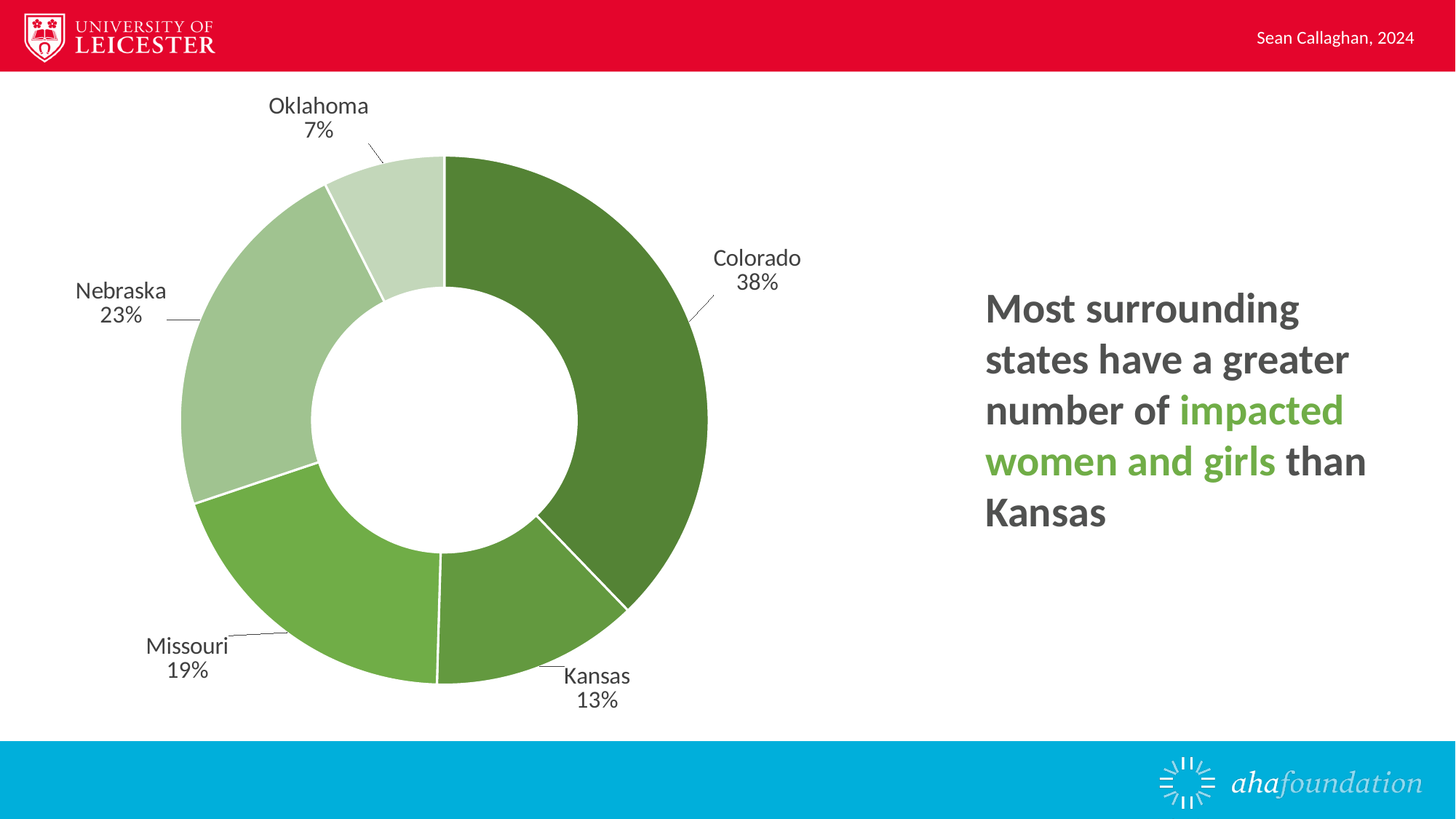
What share of the pie does Oklahoma have? 7% How many states are shown in the chart? 5 What share of the pie does Missouri have? 19% What share of the pie does Nebraska have? 23% Which has a larger share, Nebraska or Missouri? Nebraska What is the combined share of Nebraska and Missouri? 42% What is the difference in percentage points between Colorado's share and Kansas's share? 25 What kind of chart is shown on the slide? Pie chart (doughnut) What share of the pie does Colorado have? 38% What share of the pie does Kansas have? 13% Which state has the largest share of the pie? Colorado Which state has the smallest share of the pie? Oklahoma